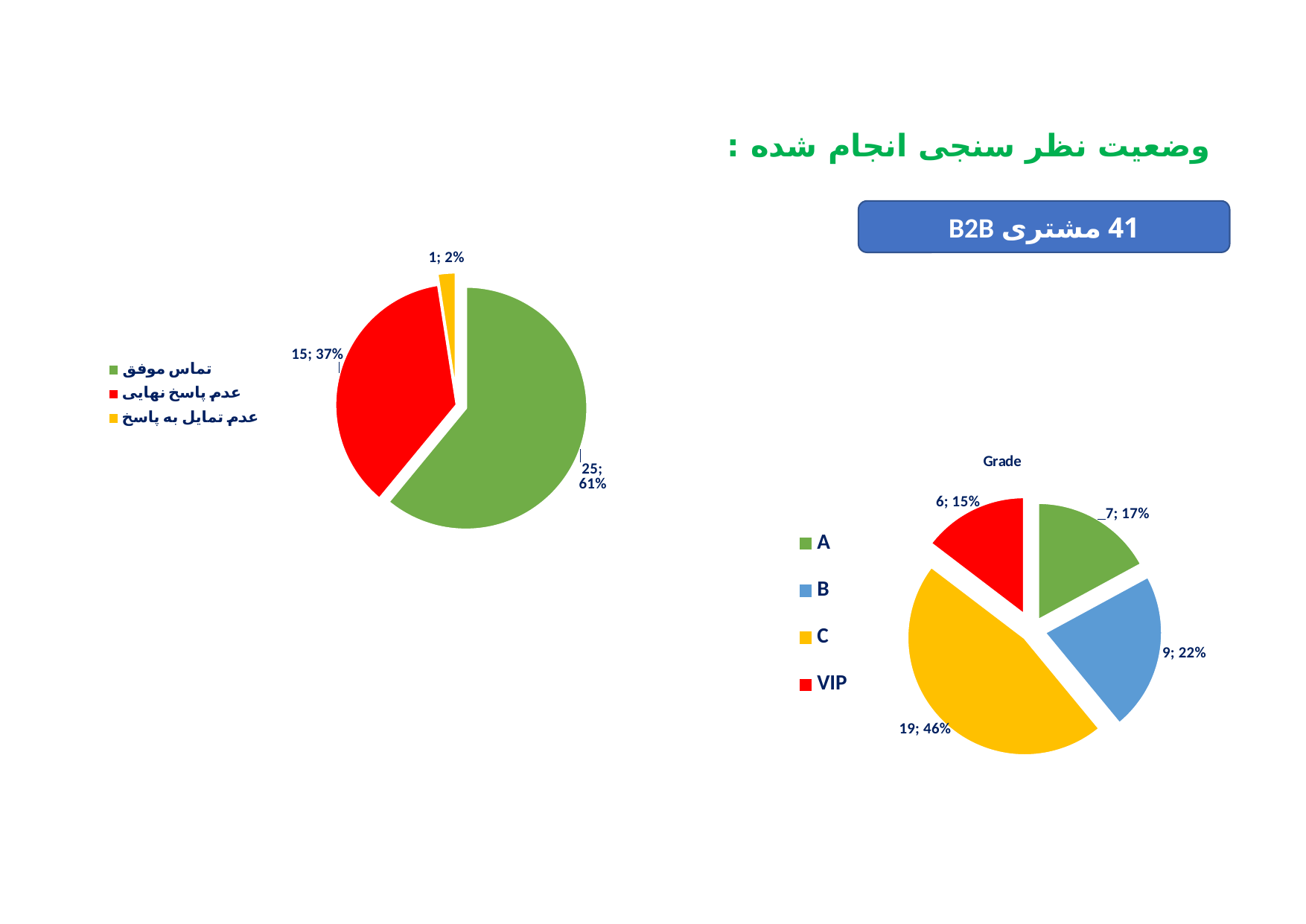
In the pie chart titled "Grade", which category has the largest slice? C In the pie chart titled "Grade", what share of the pie does B represent? 22% In the pie chart on the left side of the slide, which category has the smallest slice? عدم تمایل به پاسخ In the pie chart titled "Grade", what is the difference between the count for C and the count for A? 12 In the pie chart titled "Grade", which category has the smallest slice? VIP In the pie chart titled "Grade", which is larger, the slice for B or the slice for VIP? B In the pie chart on the left side of the slide, what is the value for تماس موفق? 25; 61% In the pie chart titled "Grade", what is the value for C? 19; 46% In the pie chart on the left side of the slide, what share of the pie does عدم پاسخ نهایی represent? 37% In the pie chart on the left side of the slide, what is the difference between the count for تماس موفق and the count for عدم پاسخ نهایی? 10 What type of chart is the chart titled "Grade"? Pie chart In the pie chart titled "Grade", how many categories does the legend list? 4